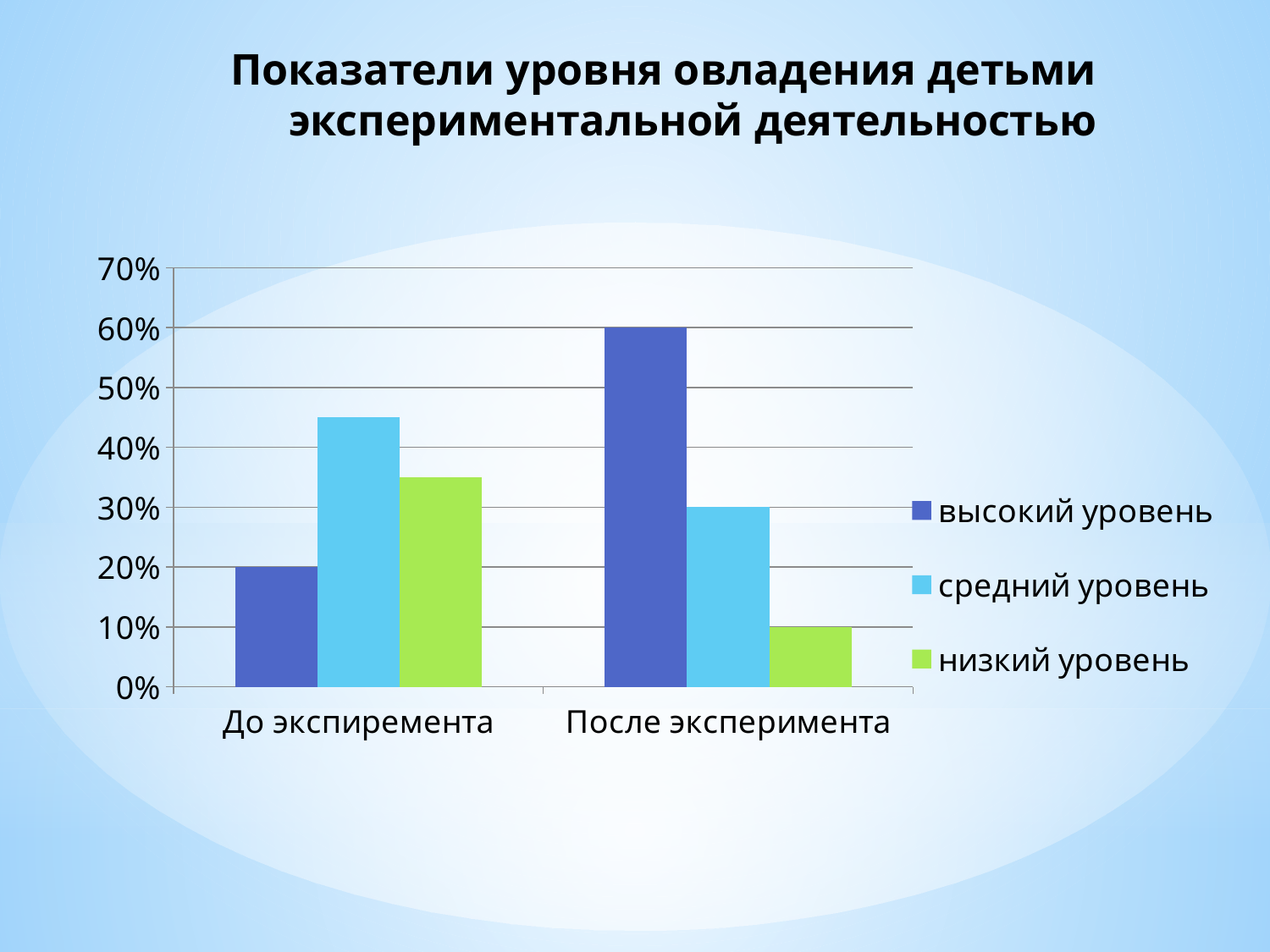
Is the value for средний уровень in the До экспиремента category greater or less than 40%? greater What type of chart is shown on the slide? bar chart How many series does the legend list? 3 Is the value for низкий уровень in the До экспиремента category greater or less than 40%? less What is the value for высокий уровень in the После эксперимента category? 60% What is the difference between the высокий уровень values for После эксперимента and До экспиремента? 40% Which series has the lowest value in the До экспиремента category? высокий уровень What is the value for высокий уровень in the До экспиремента category? 20% What is the value for средний уровень in the После эксперимента category? 30% Which series has the highest value in the После эксперимента category? высокий уровень How many categories are shown on the x axis? 2 What is the value for низкий уровень in the После эксперимента category? 10%